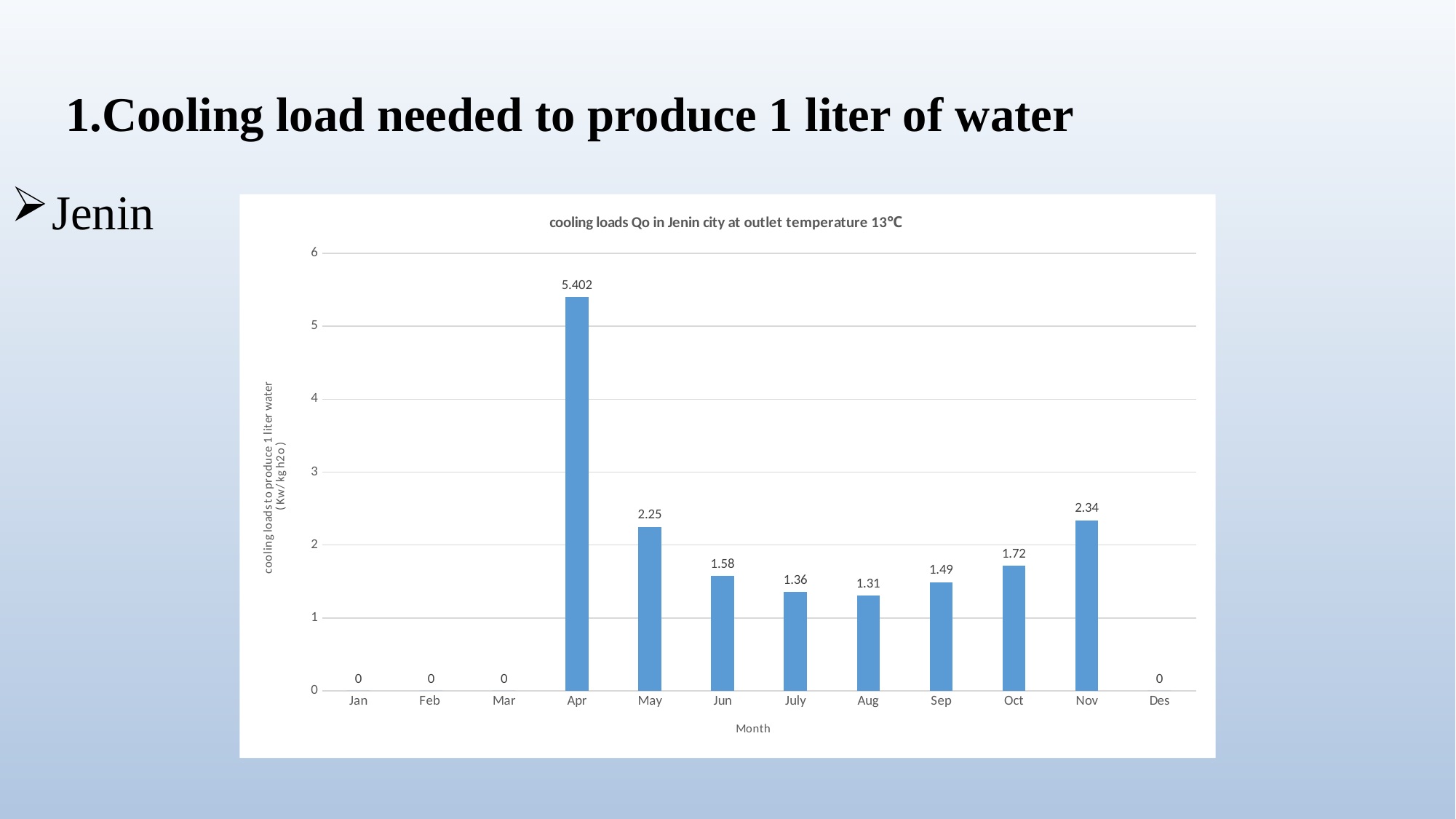
Is the value for Apr greater or less than 5? greater What is the title of the chart? cooling loads Qo in Jenin city at outlet temperature 13℃ Which month has a larger cooling load, Oct or Sep? Oct What kind of chart is shown on the slide? bar chart How many months have a cooling load value of 0? 4 Which month has the highest cooling load? Apr What is the cooling load value for Apr? 5.402 Among the months with non-zero values, which month has the lowest cooling load? Aug How many months are shown on the x axis? 12 What is the cooling load value for Nov? 2.34 What is the difference between the cooling load values for May and Jun? 0.67 What is the cooling load value for Aug? 1.31